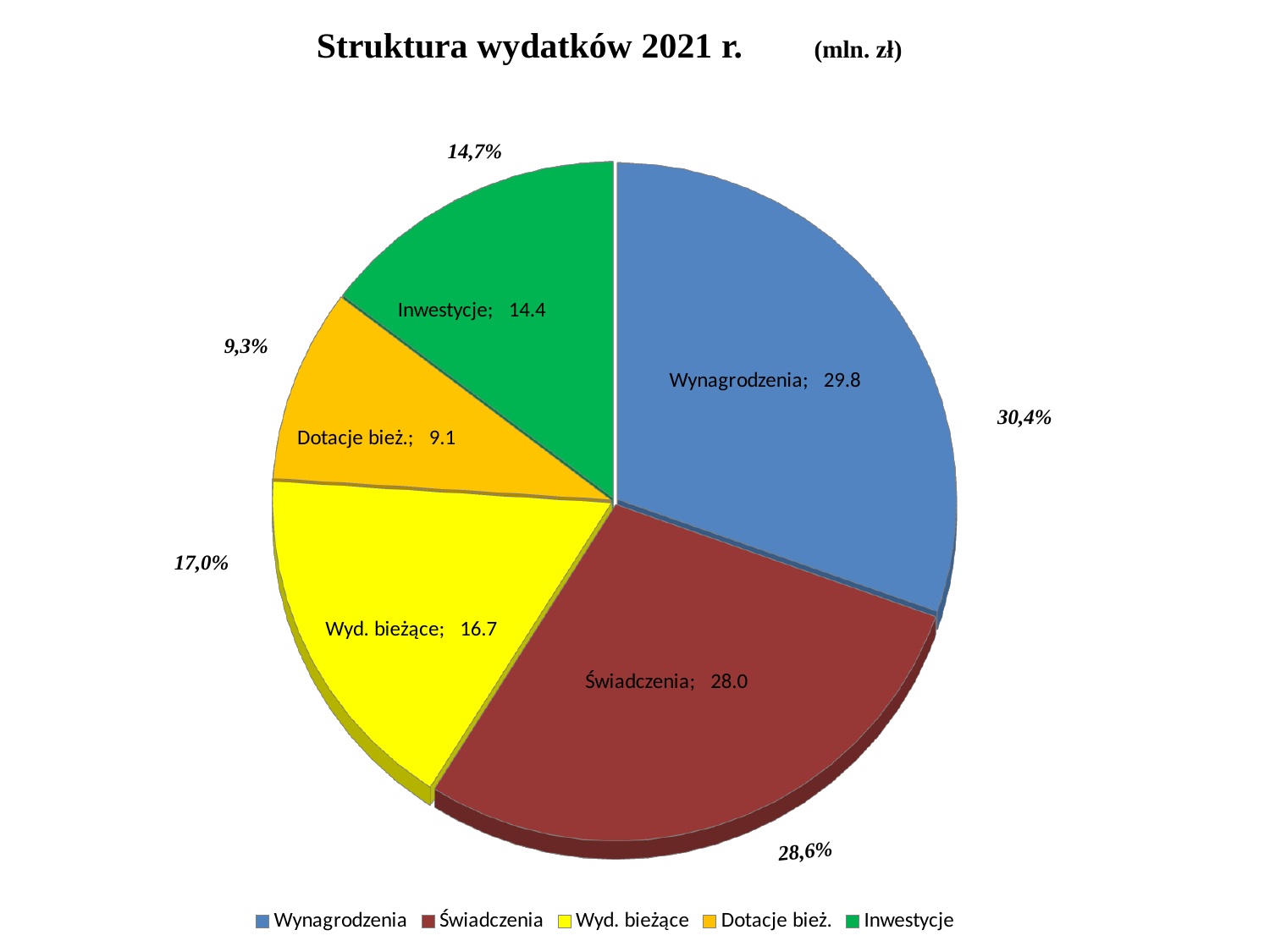
How many categories does the pie chart show? 5 What is the value for Wynagrodzenia? 29.8 What share of the pie does Wyd. bieżące represent? 17,0% What is the value for Świadczenia? 28.0 What is the value for Dotacje bież.? 9.1 What is the title of the chart? Struktura wydatków 2021 r. (mln. zł) Which category has the highest value? Wynagrodzenia What kind of chart is shown on the slide? Pie chart Which category has the lowest value? Dotacje bież. What share of the pie does Inwestycje represent? 14,7% What is the difference between the values for Wynagrodzenia and Świadczenia? 1.8 Which is larger, the value for Wyd. bieżące or the value for Inwestycje? Wyd. bieżące